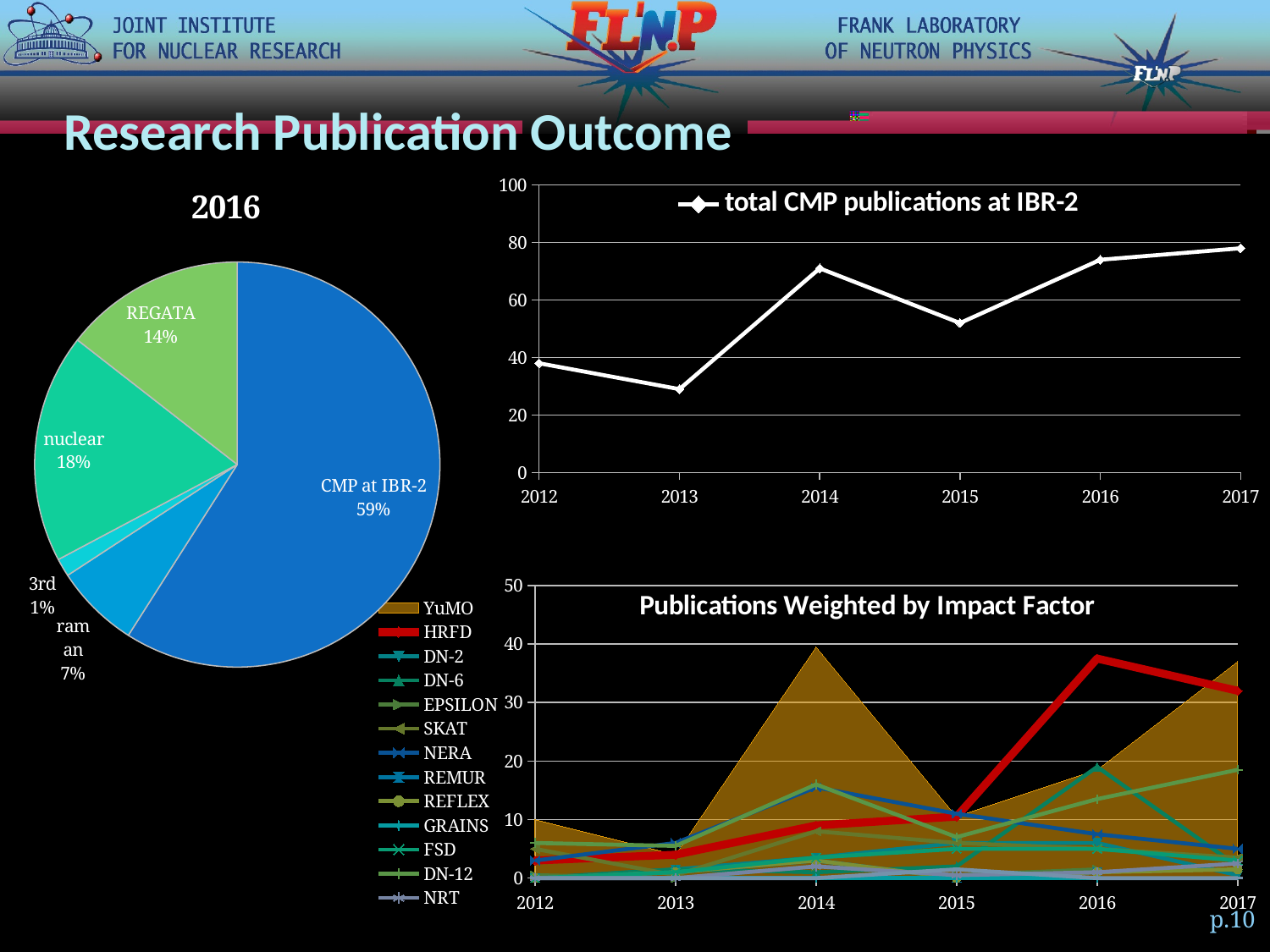
In the 2016 pie chart, which category has the smallest slice? 3rd What kind of chart is the 'total CMP publications at IBR-2' chart? Line chart In the 2016 pie chart, what percentage is shown for REGATA? 14% In the 'total CMP publications at IBR-2' chart, which year has the larger value, 2014 or 2015? 2014 In the 2016 pie chart, how many percentage points larger is the nuclear slice than the REGATA slice? 4 In the 'total CMP publications at IBR-2' chart, is the value for 2013 greater or less than 40? less In the 2016 pie chart, which category has the largest slice? CMP at IBR-2 In the 'total CMP publications at IBR-2' chart, which year has the lowest value? 2013 How many series does the legend of the 'Publications Weighted by Impact Factor' chart list? 13 In the 2016 pie chart, what share of publications is CMP at IBR-2? 59% In the 2016 pie chart, what percentage is shown for the nuclear slice? 18% In the 'total CMP publications at IBR-2' chart, is the value for 2014 greater or less than 60? greater